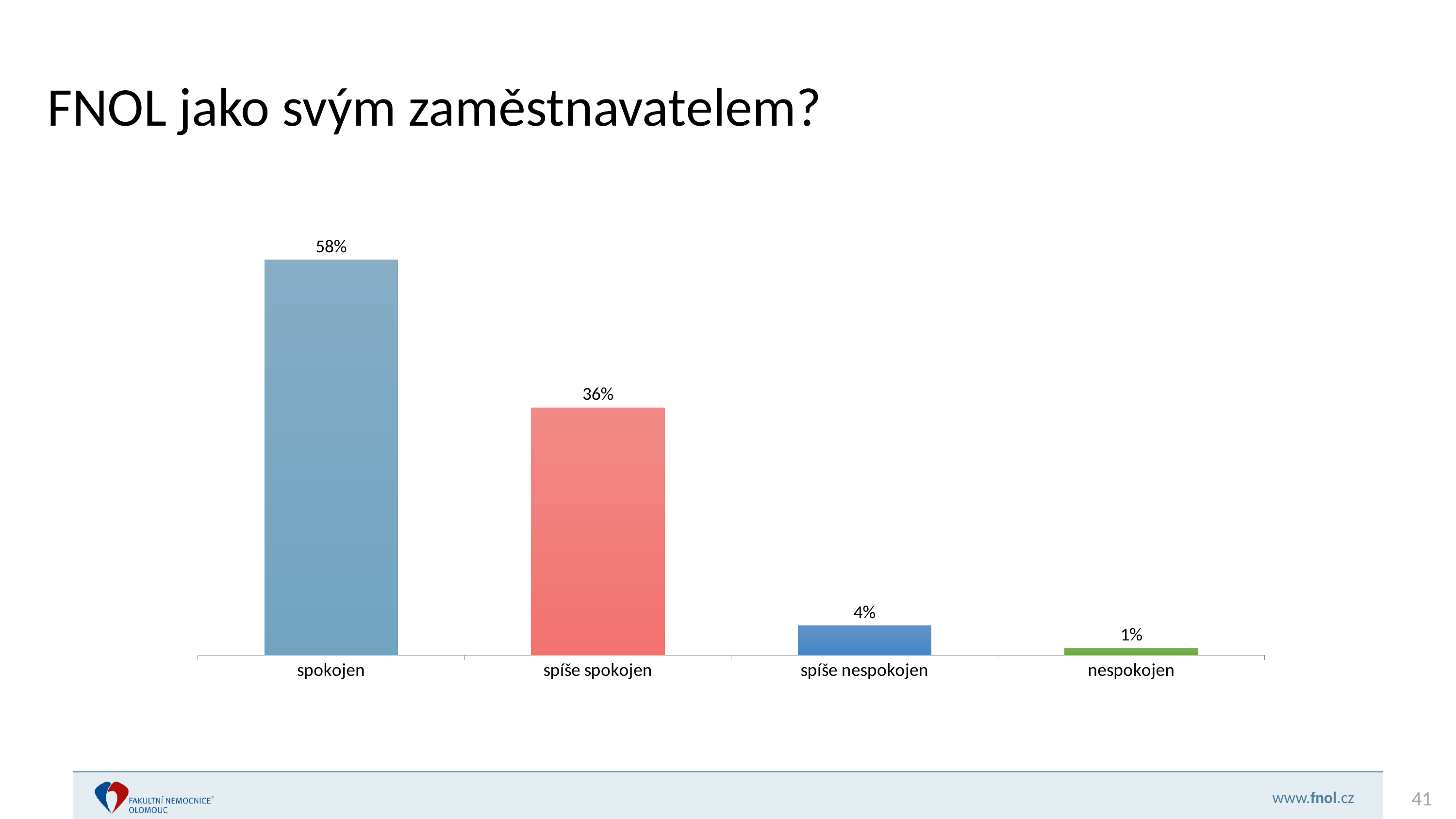
What is the value for "spokojen"? 58% What is the value for "spíše spokojen"? 36% Which category has the highest value? spokojen What is the value for "spíše nespokojen"? 4% Which category has the lowest value? nespokojen Which is larger, the value for "spíše spokojen" or the value for "spíše nespokojen"? spíše spokojen Do the values rise or fall from left to right along the x axis? fall How many categories are shown on the chart? 4 What kind of chart is shown on the slide? bar chart What is the difference between the values for "spíše nespokojen" and "nespokojen"? 3% What is the difference between the values for "spokojen" and "spíše spokojen"? 22% What is the value for "nespokojen"? 1%